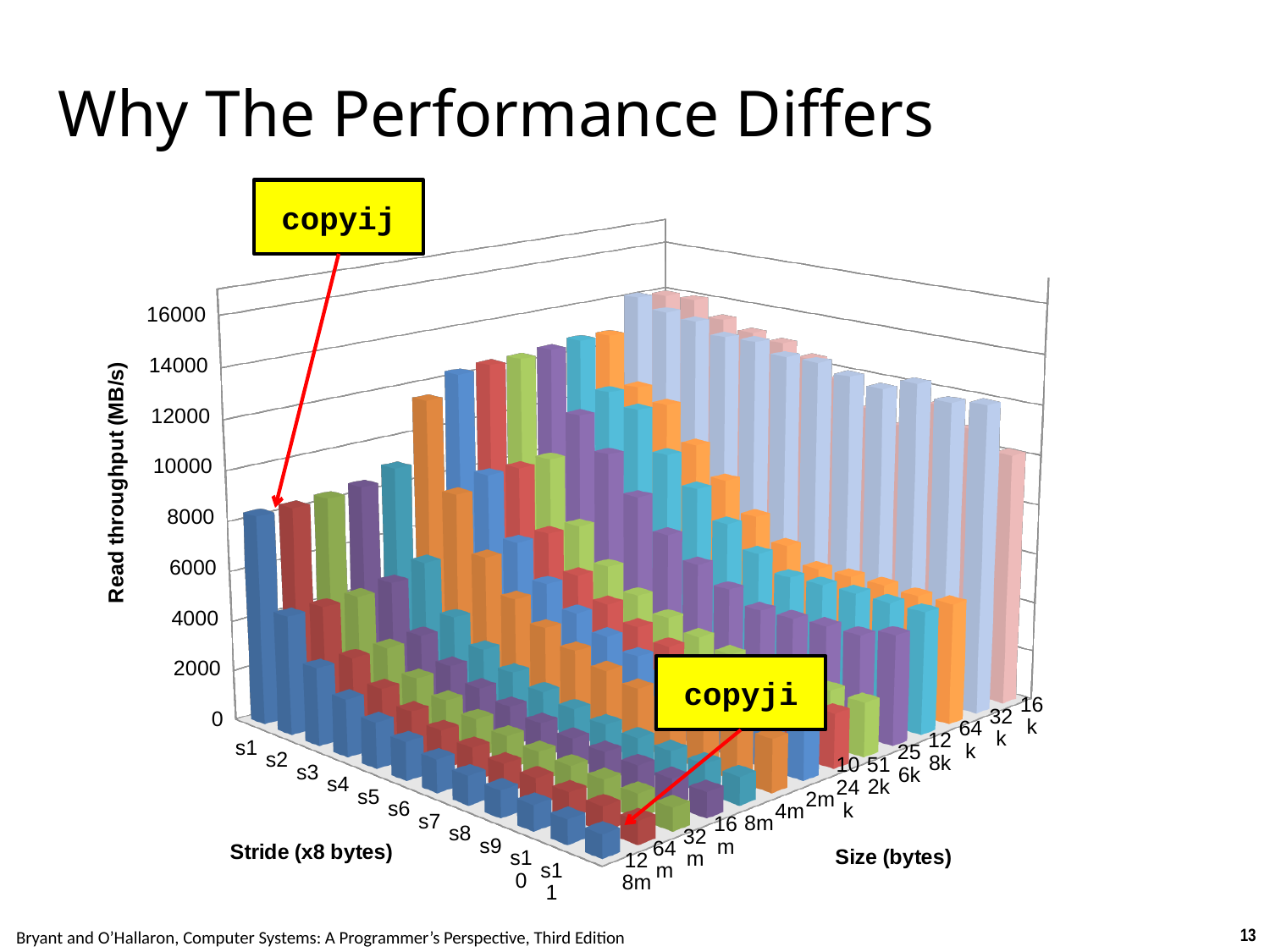
For size 128m, does read throughput rise or fall as stride increases from s1 to s11? fall For size 128m, which stride has the highest read throughput? s1 How many size categories are shown on the Size (bytes) axis? 14 What is the label of the axis showing s1 through s11? Stride (x8 bytes) What kind of chart is shown on the slide? 3D bar chart How many stride categories (s1, s2, ...) are shown on the stride axis? 11 Is the read throughput for stride s11 at size 128m greater or less than 4000? less What is the highest tick value shown on the Read throughput axis? 16000 Is the read throughput for stride s2 at size 128m greater or less than 6000? less Which of the two values is larger: read throughput at stride s1 for size 128m, or at stride s11 for size 128m? s1 for size 128m Is the read throughput for stride s1 at size 128m greater or less than 4000? greater What is the title of the vertical axis of the chart? Read throughput (MB/s)